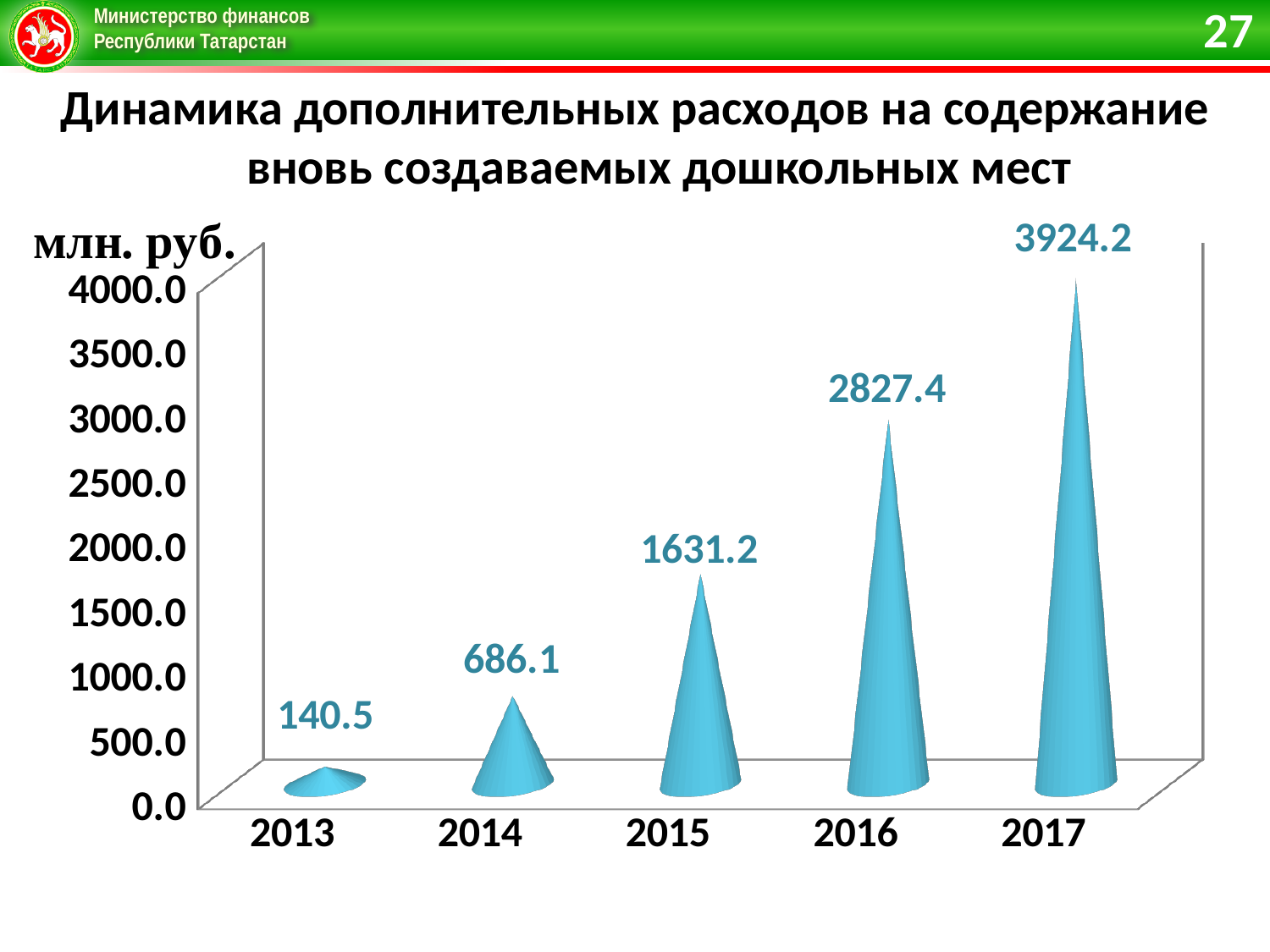
Which year has the highest value? 2017 Is the value for 2016 greater or less than 2500.0? greater Which is larger, the value for 2014 or the value for 2016? 2016 Do the values rise or fall from 2013 to 2017? rise What is the value for 2013? 140.5 What is the value for 2017? 3924.2 What unit is shown for the y axis? млн. руб. Which year has the lowest value? 2013 What is the value for 2015? 1631.2 What is the difference between the values for 2017 and 2016? 1096.8 How many years are shown on the x axis? 5 What is the difference between the values for 2015 and 2014? 945.1